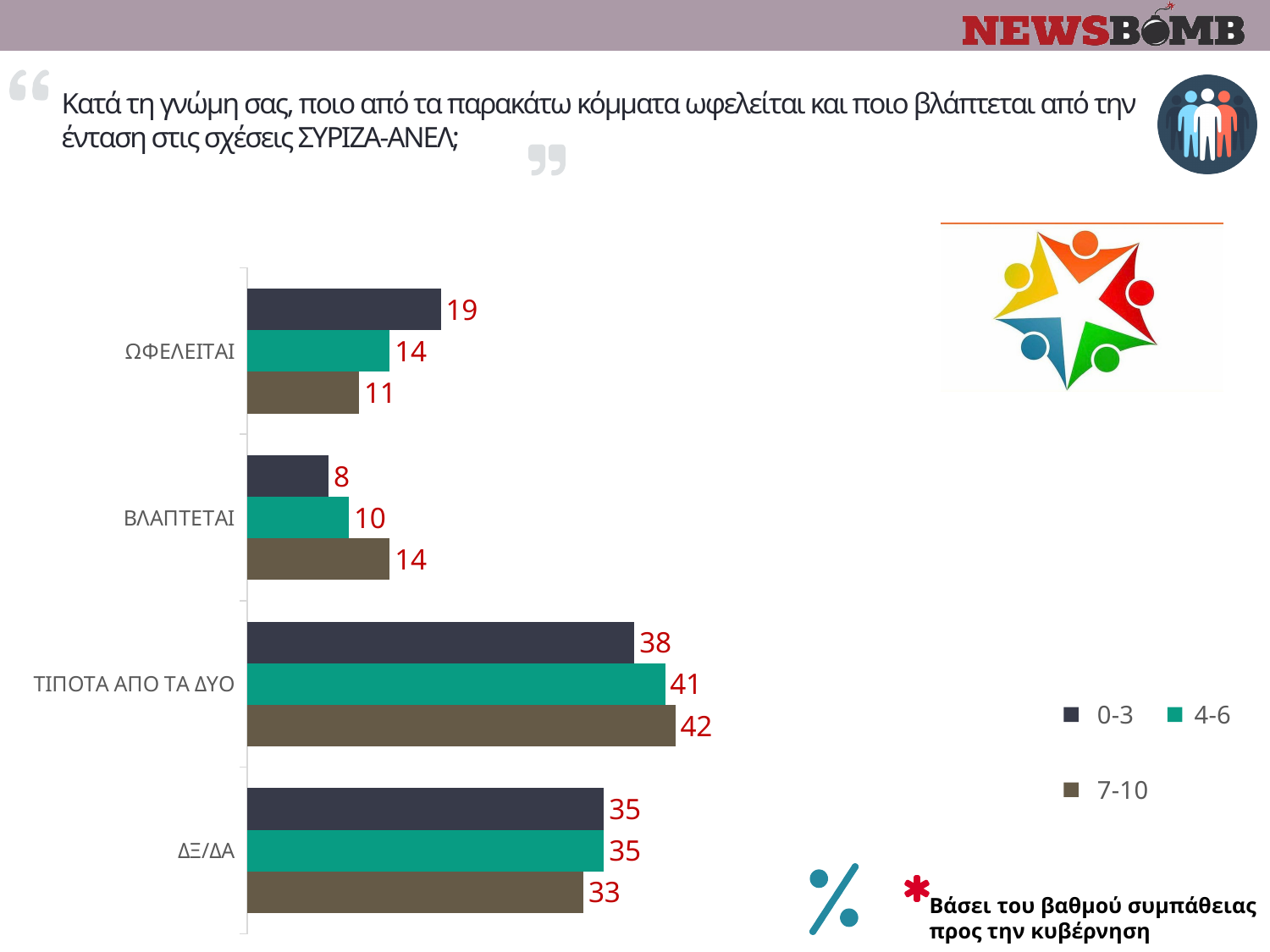
What is the value for ΩΦΕΛΕΙΤΑΙ in the 0-3 series? 19 How many categories are shown on the chart? 4 Which category has the lowest value in the 4-6 series? ΒΛΑΠΤΕΤΑΙ What is the value for ΤΙΠΟΤΑ ΑΠΟ ΤΑ ΔΥΟ in the 4-6 series? 41 What is the value for ΒΛΑΠΤΕΤΑΙ in the 7-10 series? 14 Which series is shown in green in the legend? 4-6 Which is larger for ΒΛΑΠΤΕΤΑΙ: the 0-3 value or the 4-6 value? 4-6 What is the value for ΔΞ/ΔΑ in the 7-10 series? 33 How many series does the legend list? 3 What is the difference between the 0-3 and 7-10 values for ΩΦΕΛΕΙΤΑΙ? 8 Which category has the highest value in the 0-3 series? ΤΙΠΟΤΑ ΑΠΟ ΤΑ ΔΥΟ What kind of chart is shown on the slide? Bar chart